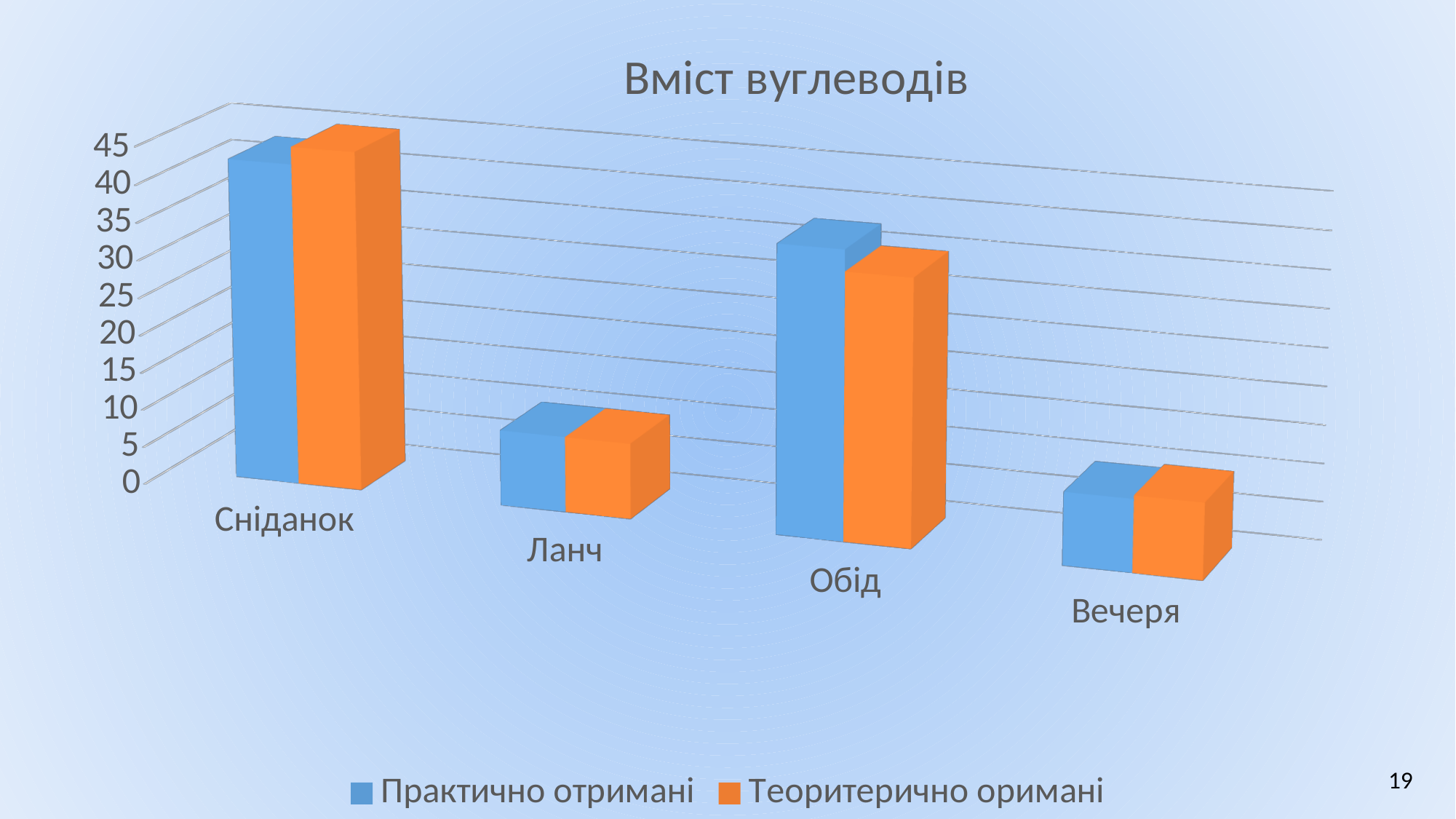
Which category has the highest value for the series Практично отримані? Сніданок Is the value for Ланч in the series Практично отримані greater or less than 20? less Which series is shown in orange in the legend? Теоритерично оримані Is the value for Вечеря in the series Теоритерично оримані greater or less than 20? less For the series Практично отримані, which is larger: Обід or Ланч? Обід How many categories are shown on the x axis of the chart? 4 What kind of chart is shown on the slide? bar chart Which category has the highest value for the series Теоритерично оримані? Сніданок What is the title of the chart? Вміст вуглеводів Is the value for Сніданок in the series Практично отримані greater or less than 30? greater How many series does the legend list? 2